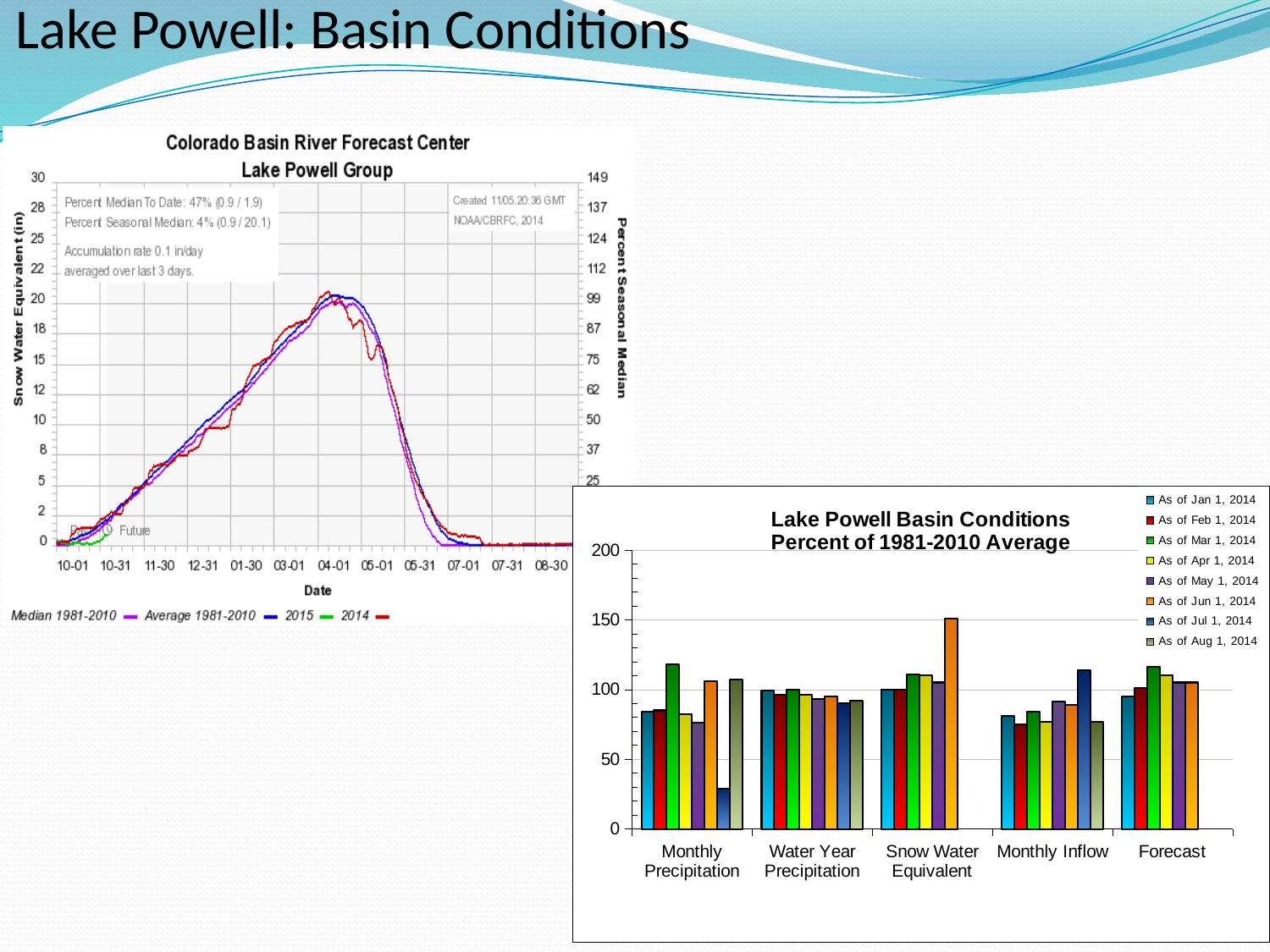
In the 'Lake Powell Basin Conditions' bar chart, is the value for Snow Water Equivalent as of Jun 1, 2014 greater or less than 100? greater In the 'Lake Powell Basin Conditions' bar chart, how many series does the legend list? 8 In the 'Lake Powell Basin Conditions' bar chart, which series has the lowest value for Monthly Precipitation? As of Jul 1, 2014 In the 'Lake Powell Basin Conditions' bar chart, which series has the highest value for Snow Water Equivalent? As of Jun 1, 2014 In the 'Lake Powell Basin Conditions' bar chart, for Monthly Precipitation, which is larger: the value as of Mar 1, 2014 or as of Jul 1, 2014? As of Mar 1, 2014 In the 'Colorado Basin River Forecast Center Lake Powell Group' line chart, what is the Percent Median To Date shown in the text box? 47% What kind of chart is the 'Colorado Basin River Forecast Center Lake Powell Group' chart? line chart In the 'Lake Powell Basin Conditions' bar chart, how many categories are shown on the x axis? 5 In the 'Lake Powell Basin Conditions' bar chart, is the value for Monthly Inflow as of Feb 1, 2014 greater or less than 100? less In the 'Lake Powell Basin Conditions' bar chart, is the value for Monthly Precipitation as of Jul 1, 2014 greater or less than 50? less In the 'Colorado Basin River Forecast Center Lake Powell Group' line chart, how many series does the legend list? 4 What kind of chart is the 'Lake Powell Basin Conditions Percent of 1981-2010 Average' chart? bar chart